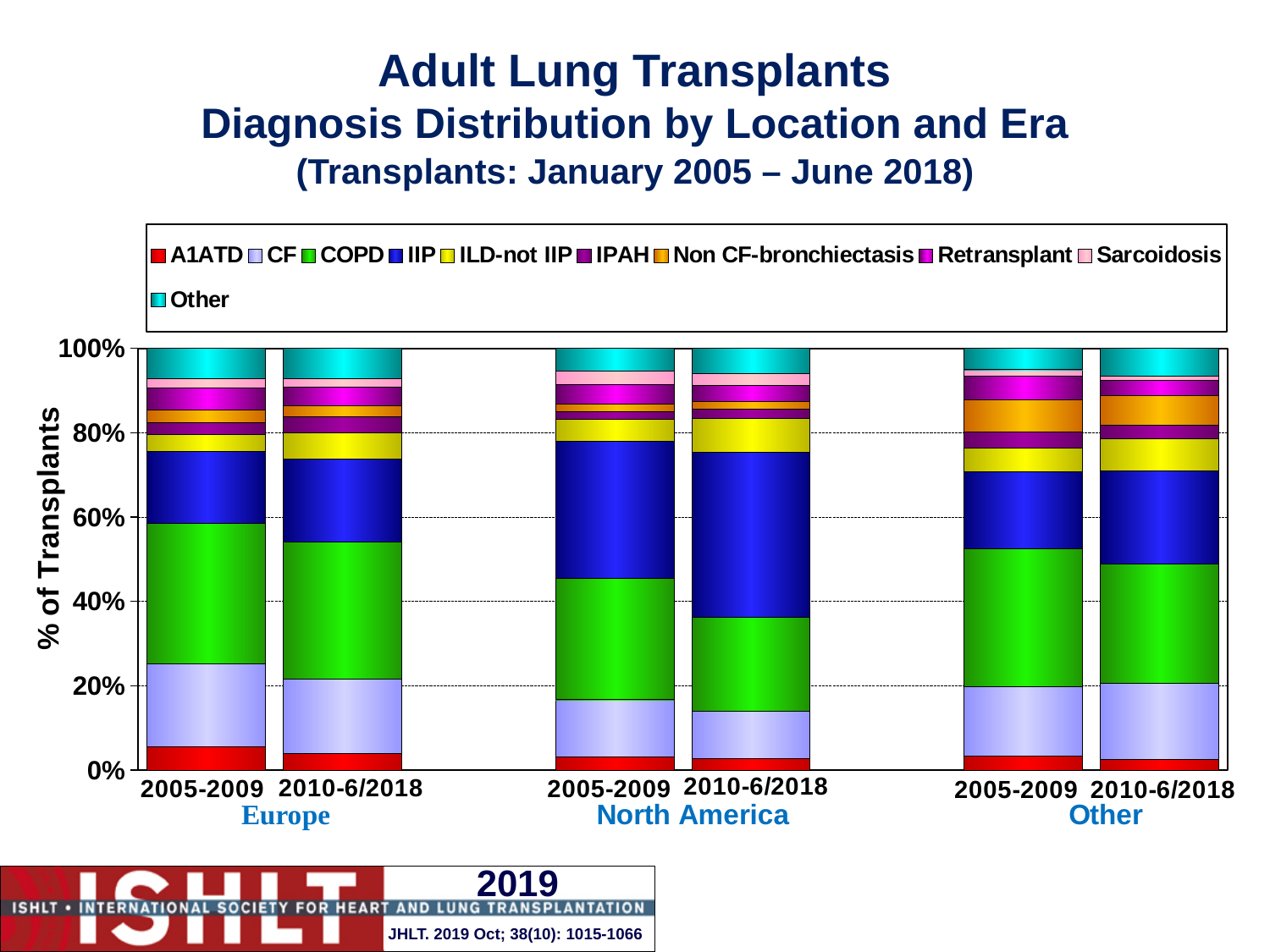
In the North America 2010-6/2018 bar, is the top of the COPD segment greater or less than 40%? less How many stacked bars are plotted in the chart? 6 For North America, does the IIP share rise or fall from 2005-2009 to 2010-6/2018? rise What is the label of the y axis? % of Transplants Which is larger: the IIP segment in the North America 2010-6/2018 bar or the IIP segment in the Europe 2005-2009 bar? North America 2010-6/2018 Which is larger: the COPD segment in the Europe 2005-2009 bar or the COPD segment in the North America 2010-6/2018 bar? Europe 2005-2009 What is the total height of each stacked bar on the y axis? 100% Which legend entry is shown in red? A1ATD How many series does the legend list? 10 What kind of chart is shown on the slide? Stacked bar chart How many locations are shown along the x axis? 3 In the Europe 2005-2009 bar, is the top of the CF segment greater or less than 20%? greater